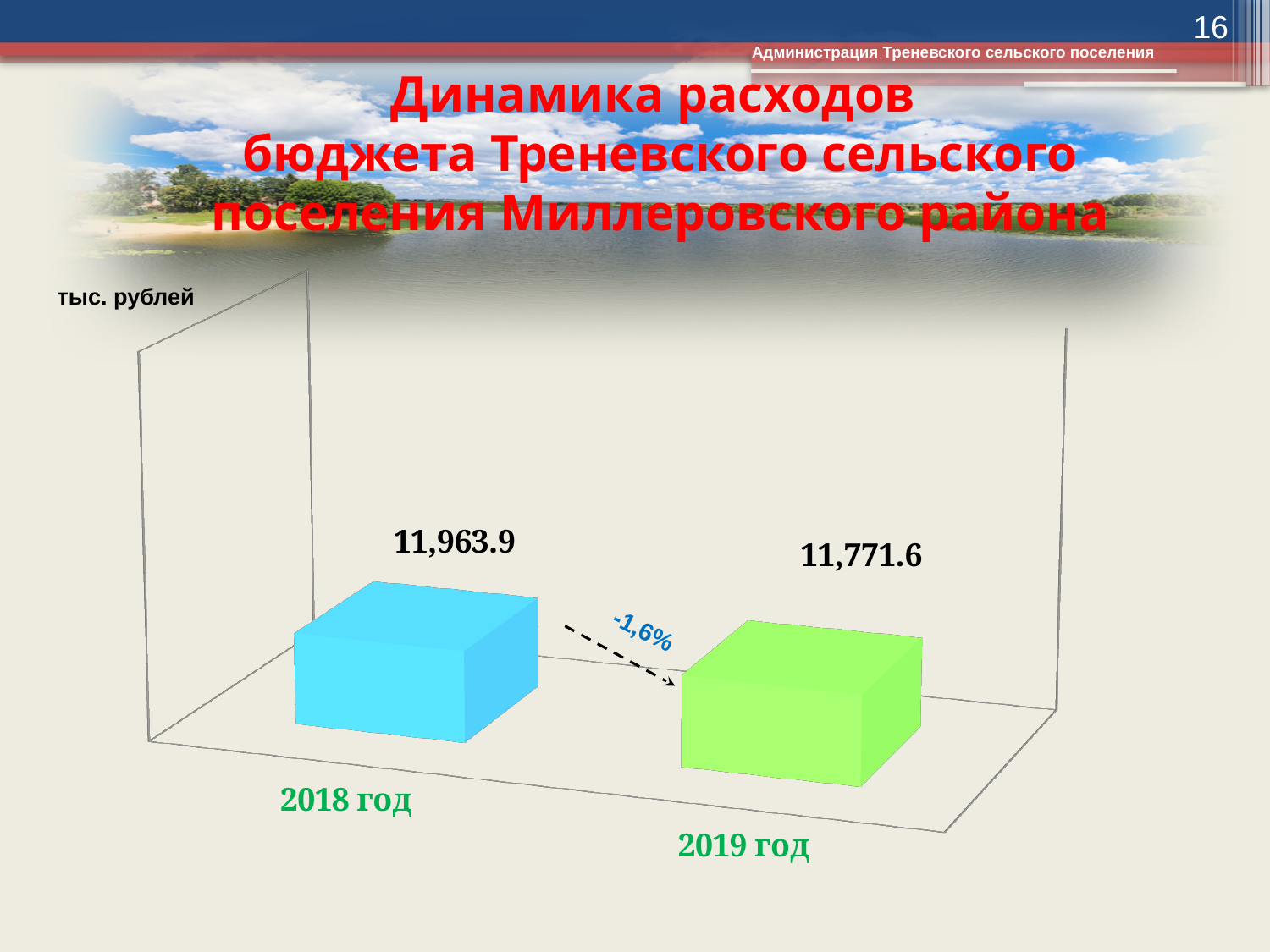
How many years (categories) are shown in the chart? 2 What is the value for 2018 год? 11,963.9 In what units are the chart values expressed? тыс. рублей What is the value for 2019 год? 11,771.6 Which year has the lower expenditure value? 2019 год Do the values rise or fall from 2018 год to 2019 год? fall What is the difference between the 2018 год and 2019 год values? 192.3 Is the value for 2018 год larger or smaller than the value for 2019 год? larger What kind of chart is shown on the slide? bar chart Which year has the higher expenditure value? 2018 год What percentage change is annotated between the two bars? -1,6%